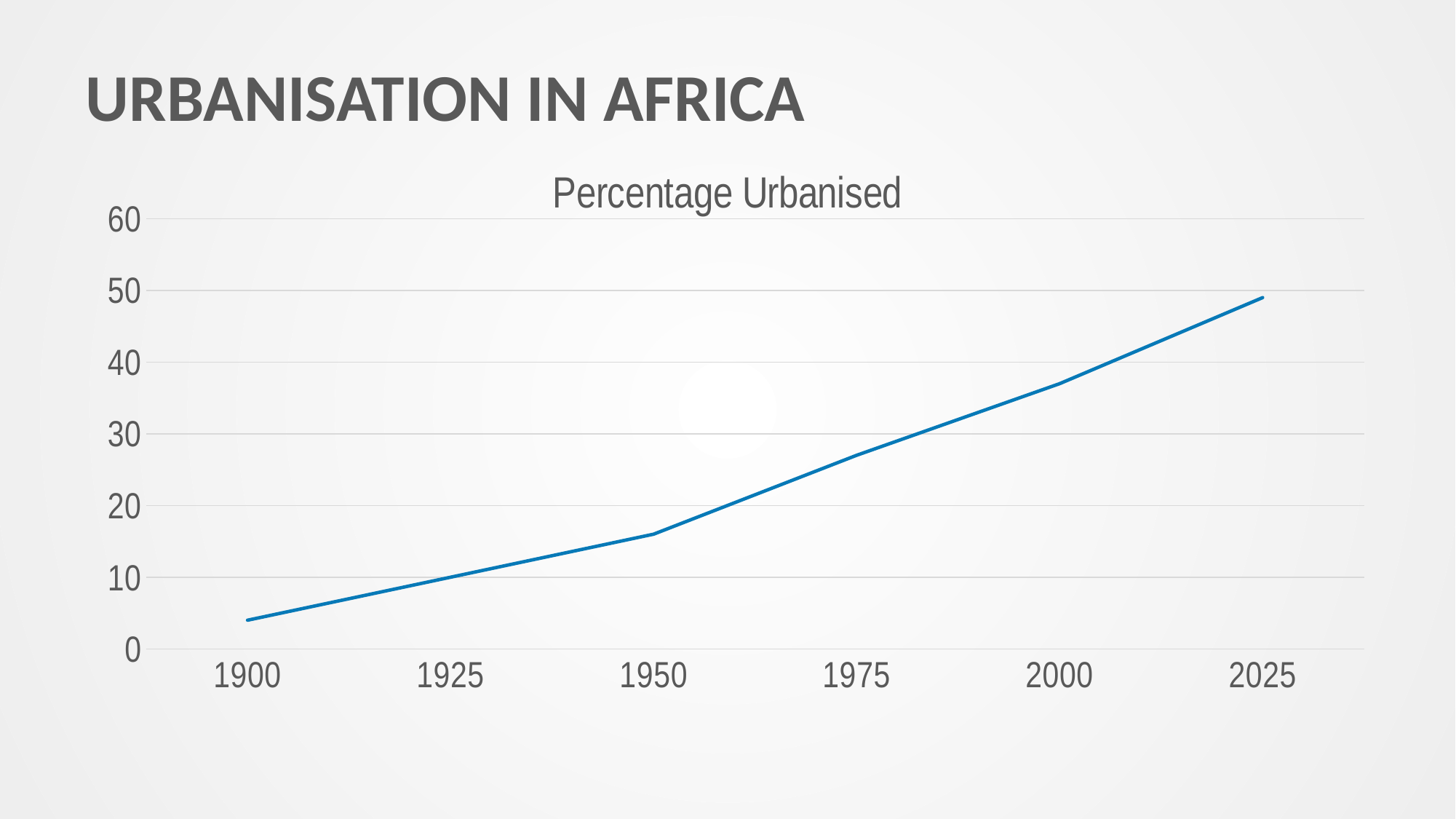
Which year has the highest percentage urbanised? 2025 Is the value for 1950 greater or less than 20? less What kind of chart is shown on the slide? line chart Does the percentage urbanised rise or fall from 1900 to 2025? rise Is the value for 2025 greater or less than 40? greater What is the title of the chart? Percentage Urbanised How many years are marked on the x axis of the chart? 6 Which year has the lowest percentage urbanised? 1900 Is the value for 2000 greater or less than 40? less Which is larger, the value for 1975 or the value for 2000? 2000